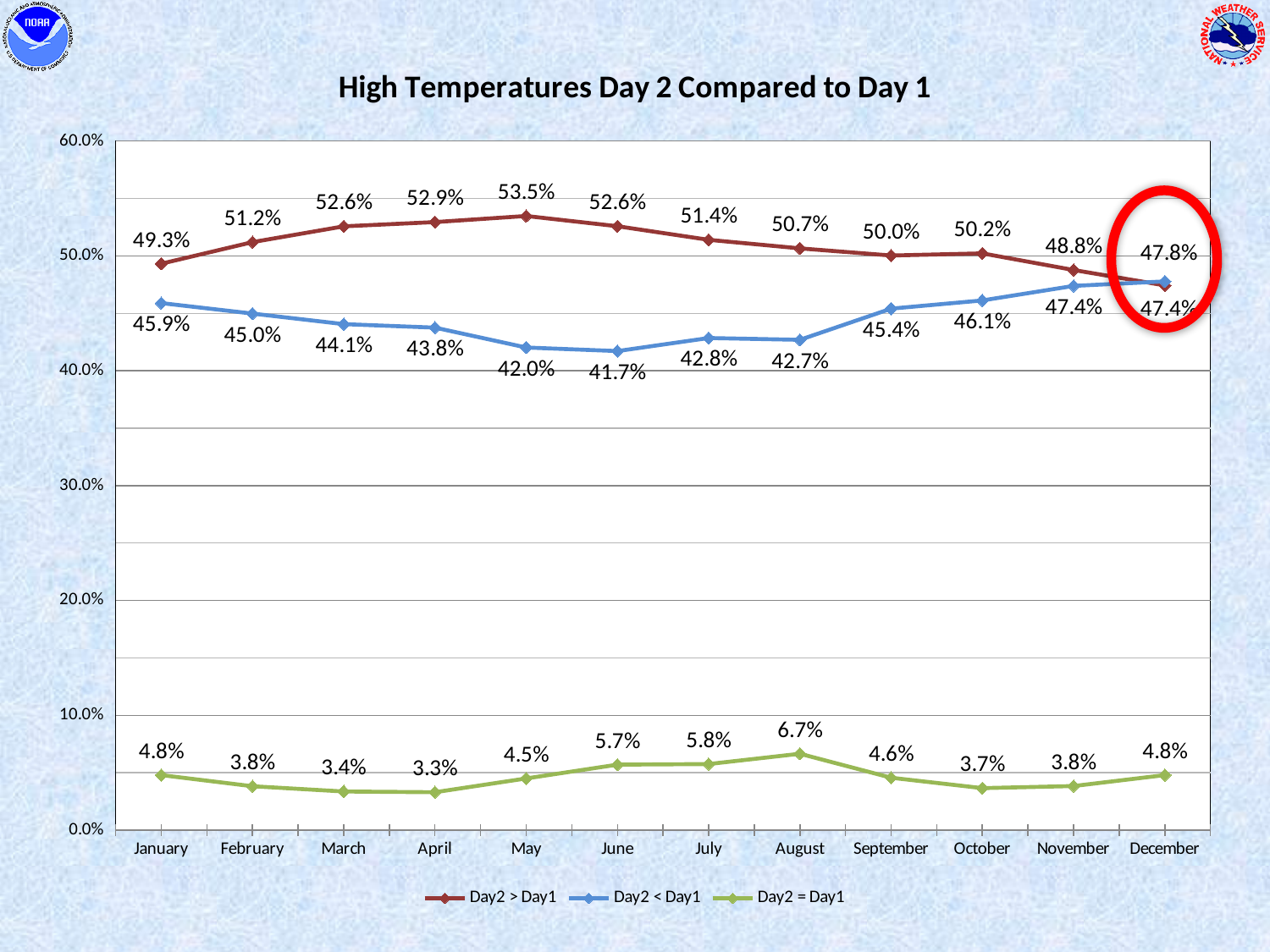
Does the Day2 < Day1 series rise or fall from August to December? rise In which month is the Day2 < Day1 series lowest? June How many months are plotted along the x axis? 12 How many series does the legend list? 3 What is the value of the Day2 = Day1 series in August? 6.7% What kind of chart is shown on the slide? line chart What is the value of the Day2 > Day1 series in May? 53.5% What is the difference between the Day2 > Day1 and Day2 < Day1 values in May? 11.5% In which month is the Day2 > Day1 series highest? May In which month is the Day2 = Day1 series lowest? April In December, which series has the larger value, Day2 > Day1 or Day2 < Day1? Day2 < Day1 What is the value of the Day2 < Day1 series in June? 41.7%